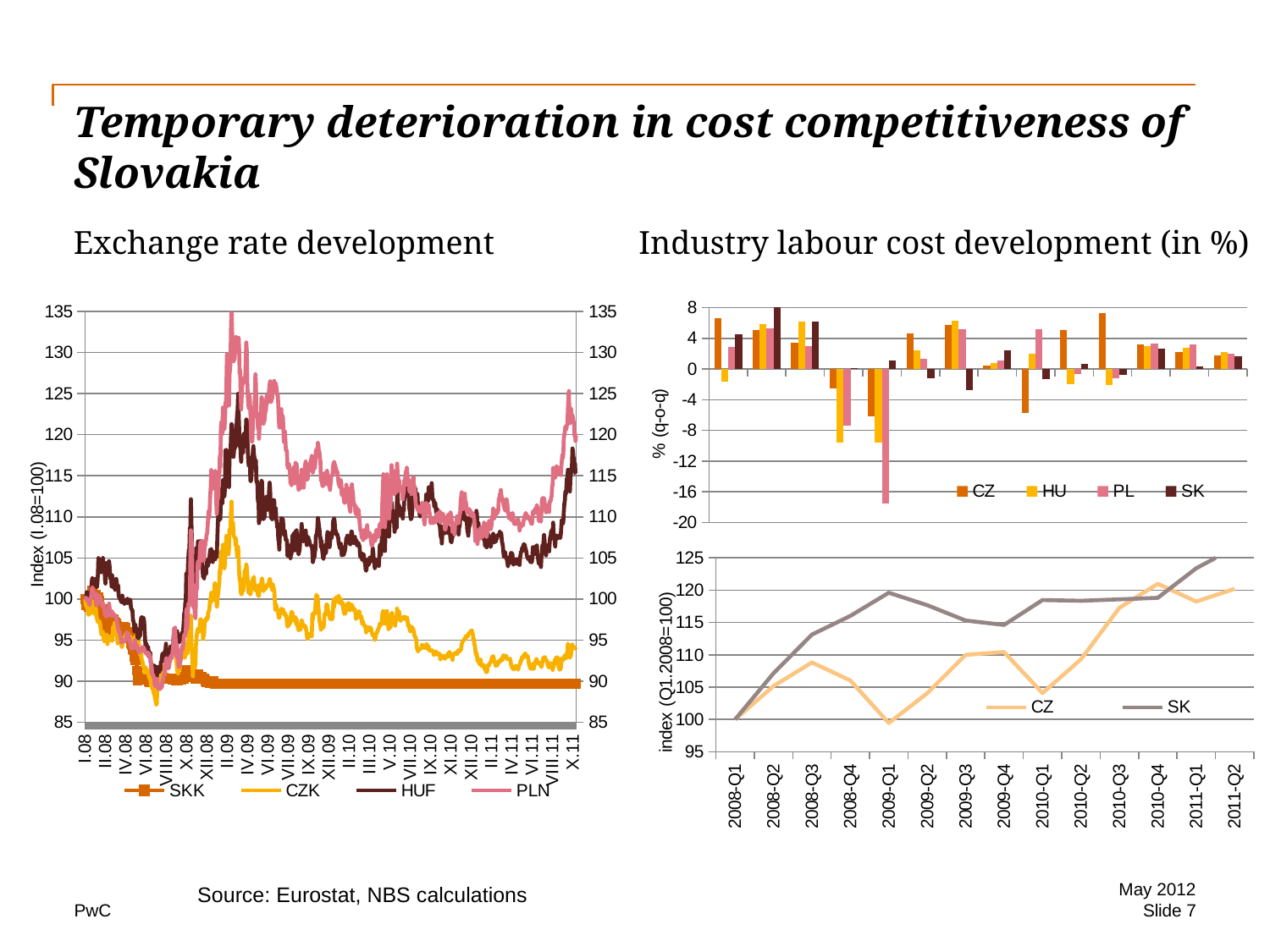
How many series does the legend of the top-right bar chart under 'Industry labour cost development (in %)' list? 4 In the bottom-right line chart (index Q1.2008=100), is the value for SK in 2011-Q2 greater or less than 120? greater In the bottom-right line chart (index Q1.2008=100), what is the value of SK in 2008-Q1? 100 In the 'Exchange rate development' chart, which series reaches the highest peak? PLN In the 'Exchange rate development' chart, is the value for CZK in X.11 greater or less than 100? less In the top-right bar chart under 'Industry labour cost development (in %)', is the value for PL in 2009-Q1 greater or less than -12? less How many quarters are shown on the x axis of the bottom-right line chart (index Q1.2008=100)? 14 In the bottom-right line chart (index Q1.2008=100), which series has the larger value in 2009-Q1, CZ or SK? SK What kind of chart is the 'Exchange rate development' chart on the left? line chart How many series does the legend of the 'Exchange rate development' chart list? 4 How many series does the legend of the bottom-right line chart (index Q1.2008=100) list? 2